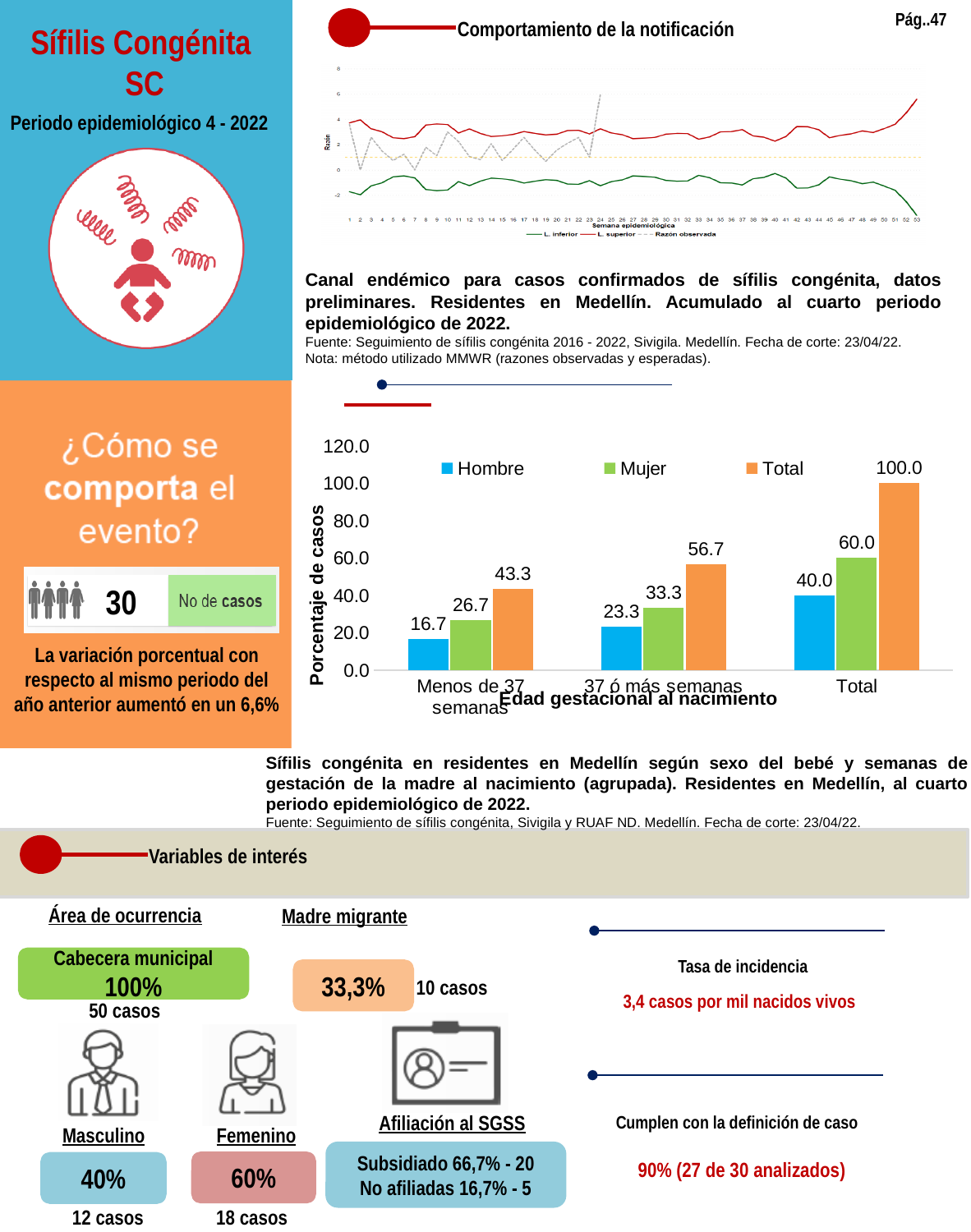
In the bar chart, which category has the highest value for the Total series? Total In the bar chart, what is the difference between the Mujer and Hombre values in the 'Total' category? 20.0 In the bar chart, is the Mujer value larger for 'Menos de 37 semanas' or for '37 ó más semanas'? 37 ó más semanas What is the y-axis title of the bar chart? Porcentaje de casos In the bar chart, what is the value for Hombre in the 'Menos de 37 semanas' category? 16.7 In the bar chart, what is the value of the Total series for the 'Total' category? 100.0 How many categories are shown on the x axis of the bar chart? 3 In the bar chart, which category has the lowest value for the Hombre series? Menos de 37 semanas What kind of chart is the chart showing percentages by 'Edad gestacional al nacimiento'? Bar chart How many series does the legend of the bar chart list? 3 How many series does the legend of the top chart (Comportamiento de la notificación) list? 3 In the bar chart, what is the value for Mujer in the '37 ó más semanas' category? 33.3